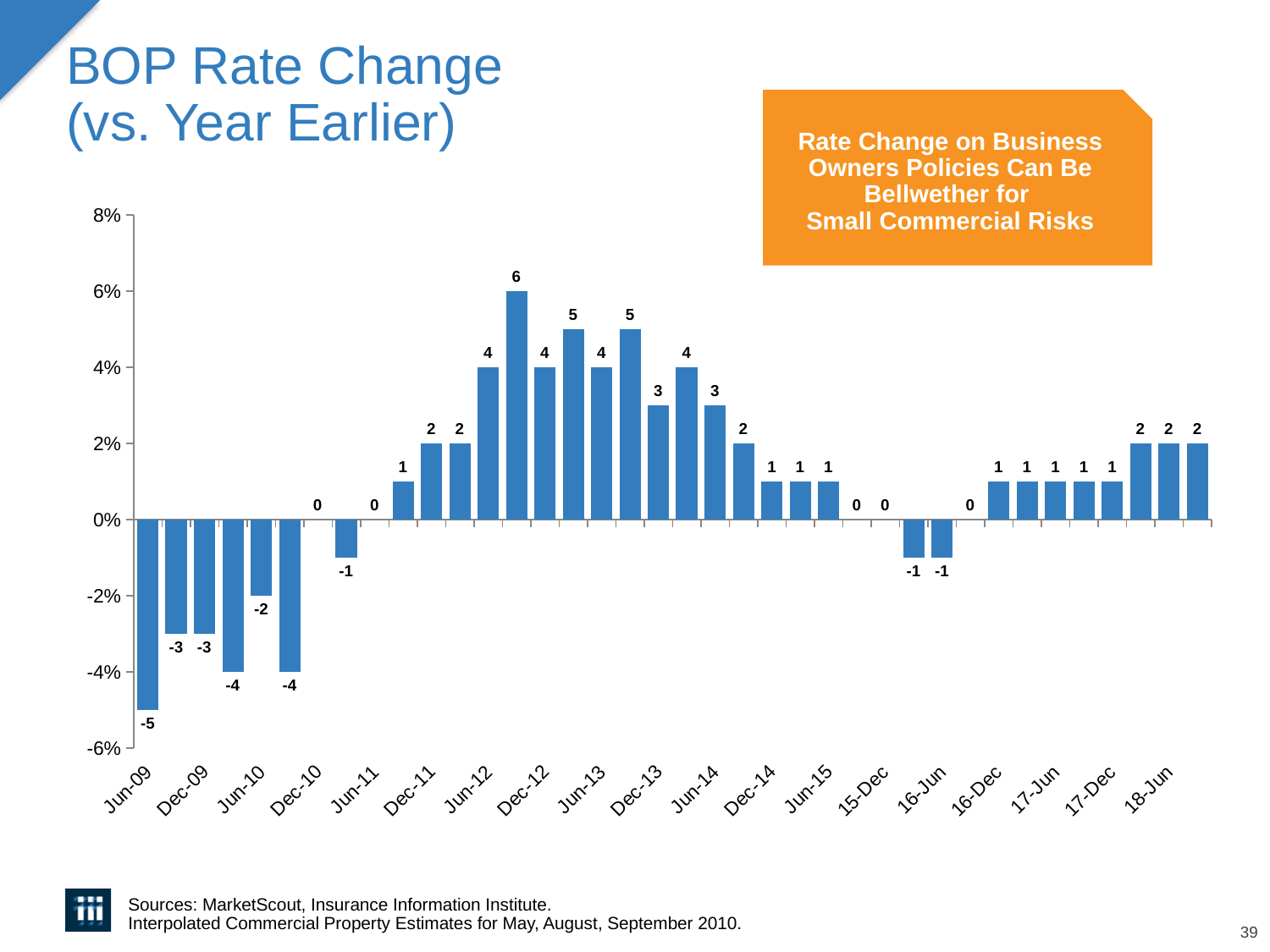
What is the difference between the highest and lowest values in the chart? 11 What is the BOP rate change value for Jun-09? -5 How many bars in the chart are labeled 5? 2 Which is larger, the value for Jun-09 or the value for 18-Jun? 18-Jun What is the title of the chart? BOP Rate Change (vs. Year Earlier) Do the values rise or fall from Jun-09 through Dec-11? rise Is the tallest bar in the chart greater or less than 4%? greater How many bars are plotted in the chart? 38 What is the highest value plotted in the BOP Rate Change chart? 6 What kind of chart is shown on the slide? bar chart What is the lowest value plotted in the BOP Rate Change chart? -5 What is the highest value shown on the y-axis? 8%